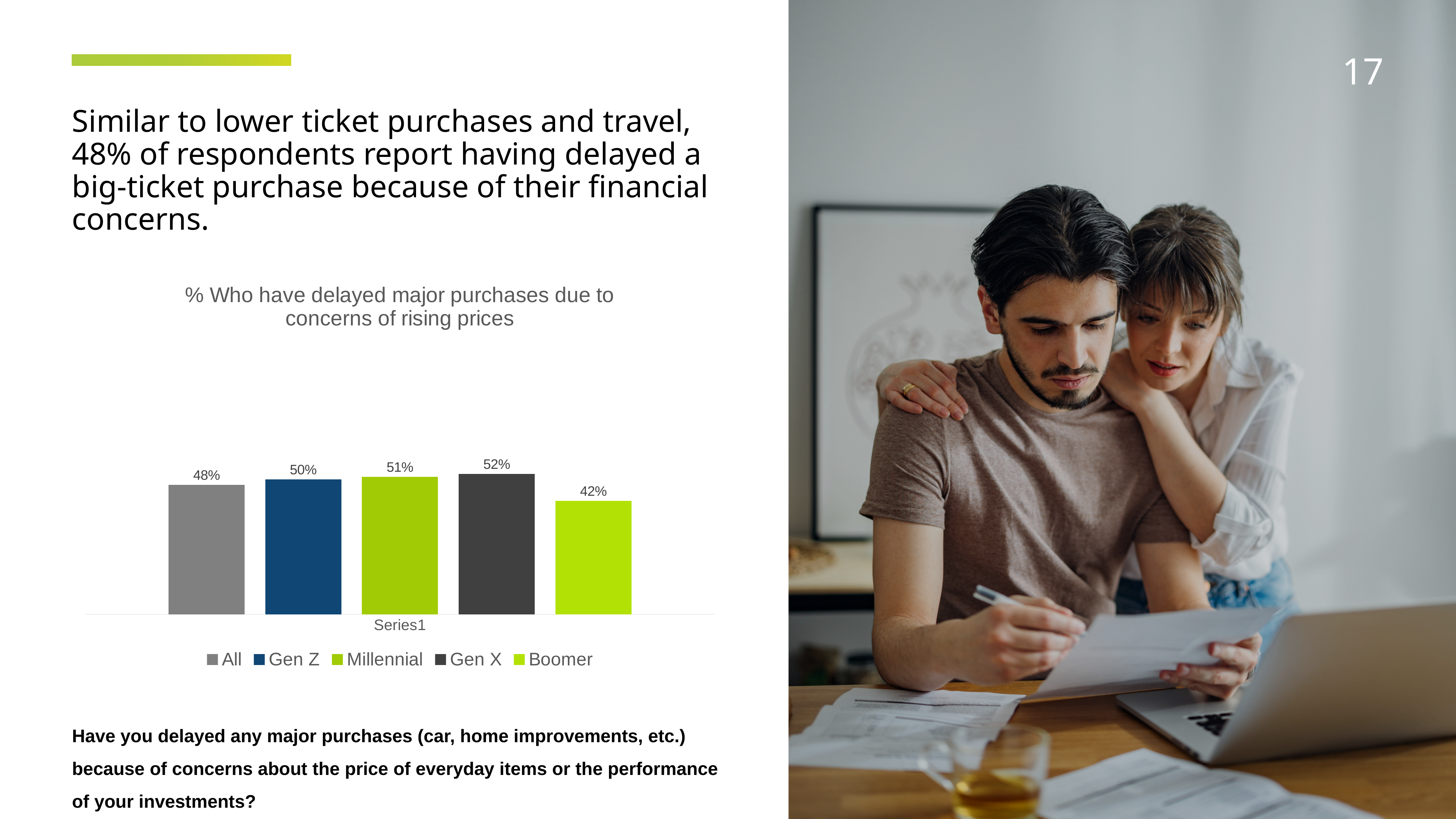
What kind of chart is shown? Bar chart What is the title of the chart? % Who have delayed major purchases due to concerns of rising prices How many bars are shown in the chart? 5 What is the value for Boomer? 42% How many entries does the legend list? 5 What is the value for All? 48% Which group has the lowest value? Boomer What is the value for Gen Z? 50% What is the value for Millennial? 51% Which is larger, the value for Gen Z or the value for Boomer? Gen Z What is the difference between the Gen X value and the Boomer value? 10% Which group has the highest value? Gen X